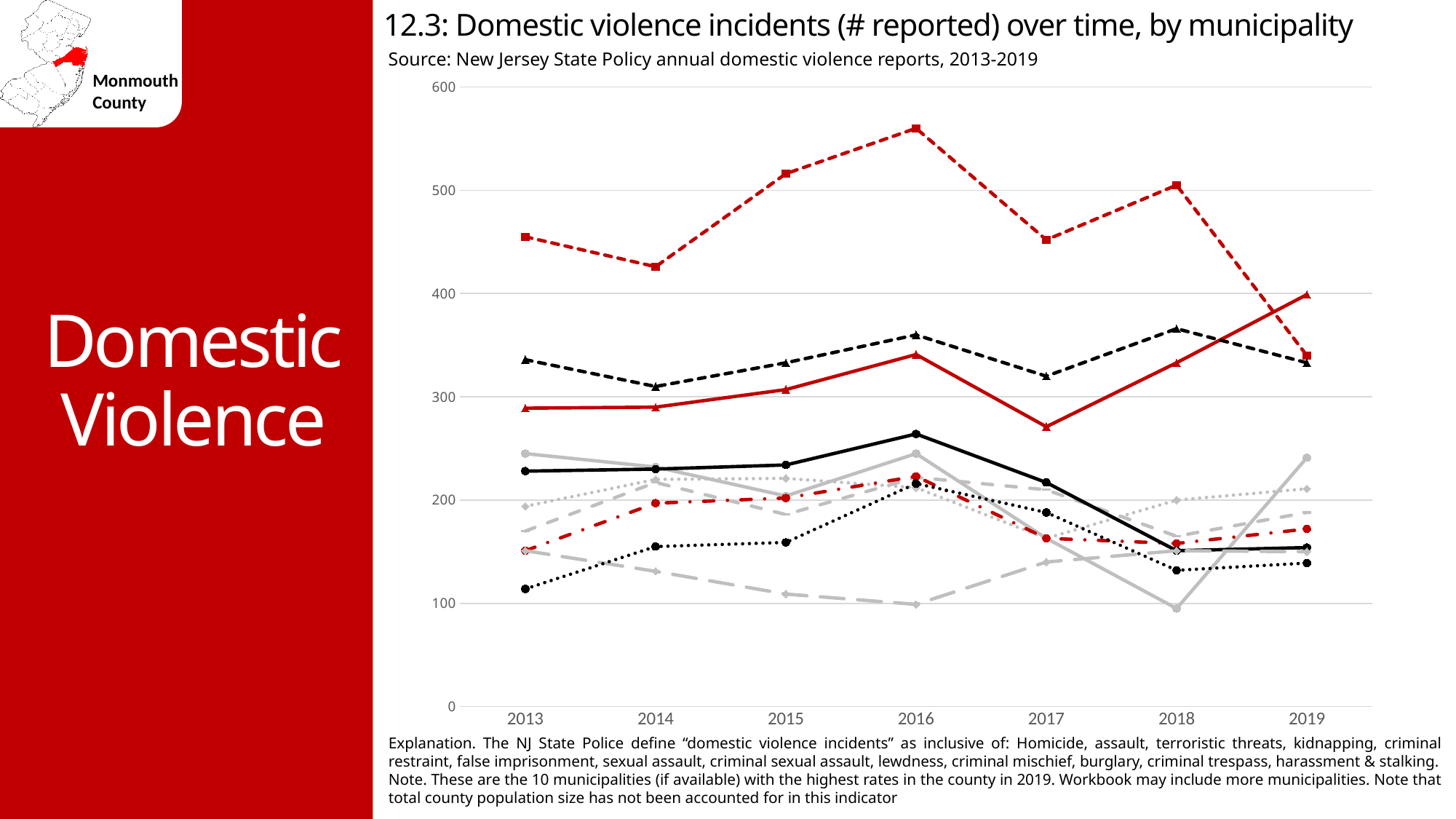
Is the lowest value plotted for 2013 greater or less than 200? less What kind of chart is shown on the slide? line chart What is the first year shown on the x axis? 2013 Is the highest value plotted for 2019 greater or less than 500? less What is the highest value labelled on the y axis? 600 How many years are shown along the x axis of the chart? 7 What is the title of the chart? 12.3: Domestic violence incidents (# reported) over time, by municipality What is the last year shown on the x axis? 2019 In which year does the highest value plotted on the chart occur? 2016 Is the highest value plotted for 2016 greater or less than 500? greater